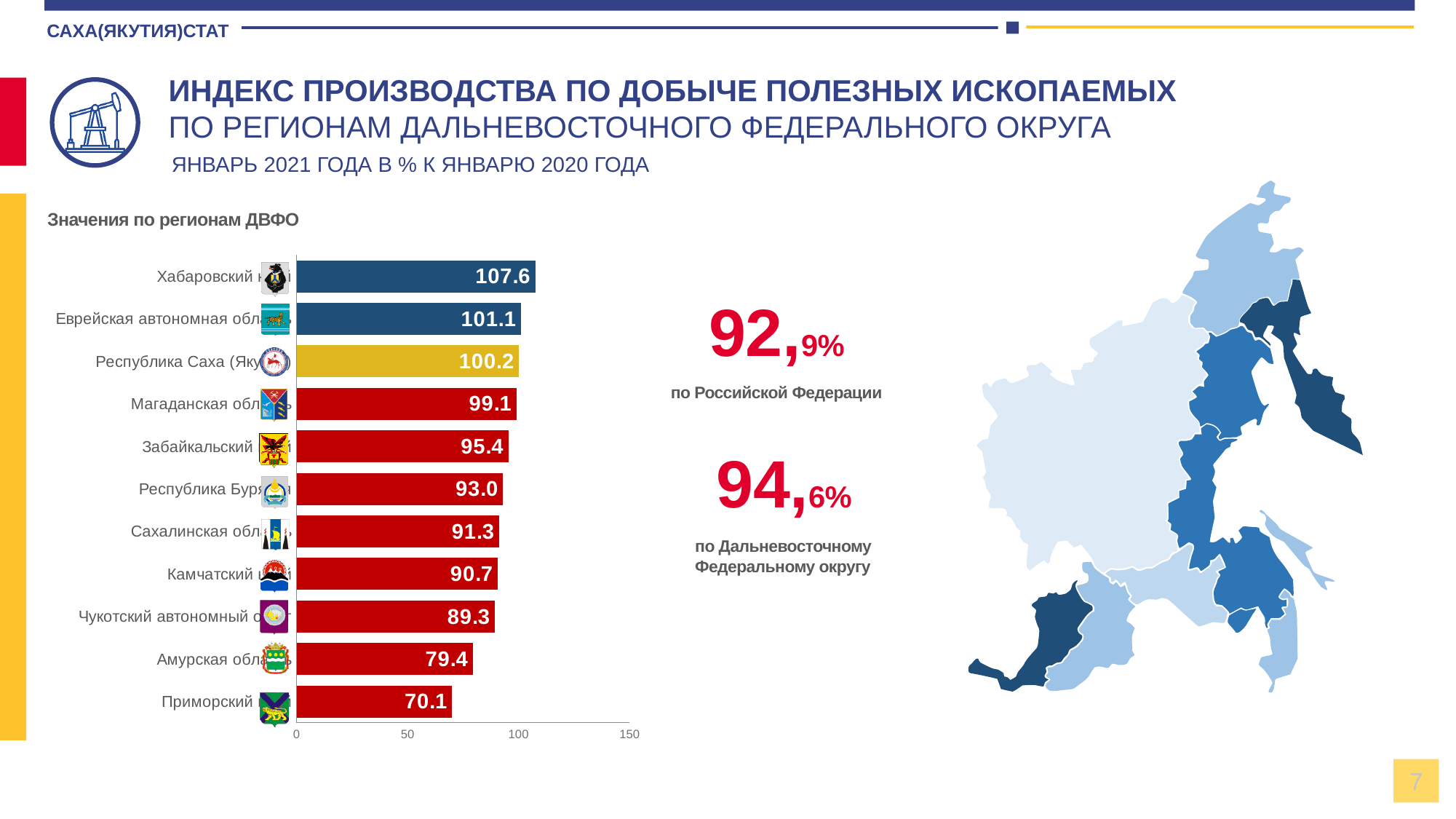
What is the difference between the values for Магаданская область and Амурская область? 19.7 What is the value for Хабаровский край? 107.6 Which region has the highest value in the bar chart? Хабаровский край What kind of chart is shown on the slide? bar chart What is the value for Республика Саха (Якутия)? 100.2 Which region has the lowest value in the bar chart? Приморский край What is the value for Амурская область? 79.4 How many regions are shown in the bar chart? 11 What is the difference between the values for Хабаровский край and Приморский край? 37.5 Is the value for Забайкальский край greater or less than 100? less Which region's bar is coloured yellow in the chart? Республика Саха (Якутия) Which is larger, the value for Сахалинская область or the value for Чукотский автономный округ? Сахалинская область